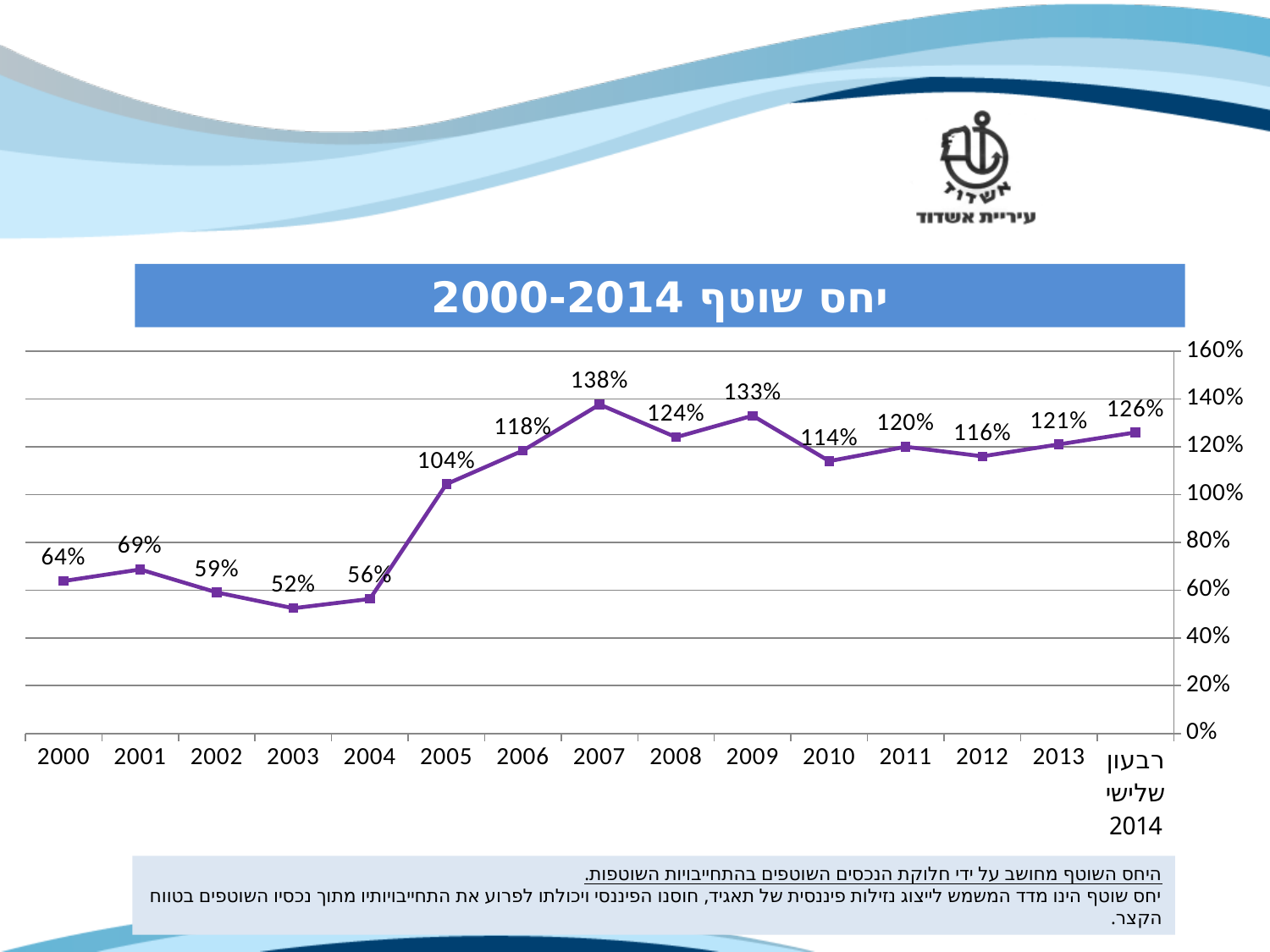
What is the value for 2007? 138% What kind of chart is shown on the slide? line chart Is the value for 2002 greater or less than 80%? less Which year has the lowest value? 2003 What is the value for 2003? 52% What is the difference between the values for 2005 and 2004? 48% What is the difference between the values for 2007 and 2006? 20% What is the value for רבעון שלישי 2014? 126% What is the title of the chart? יחס שוטף 2000-2014 Which year has the highest value? 2007 Which is larger, the value for 2009 or the value for 2010? 2009 How many data points are plotted on the chart? 15